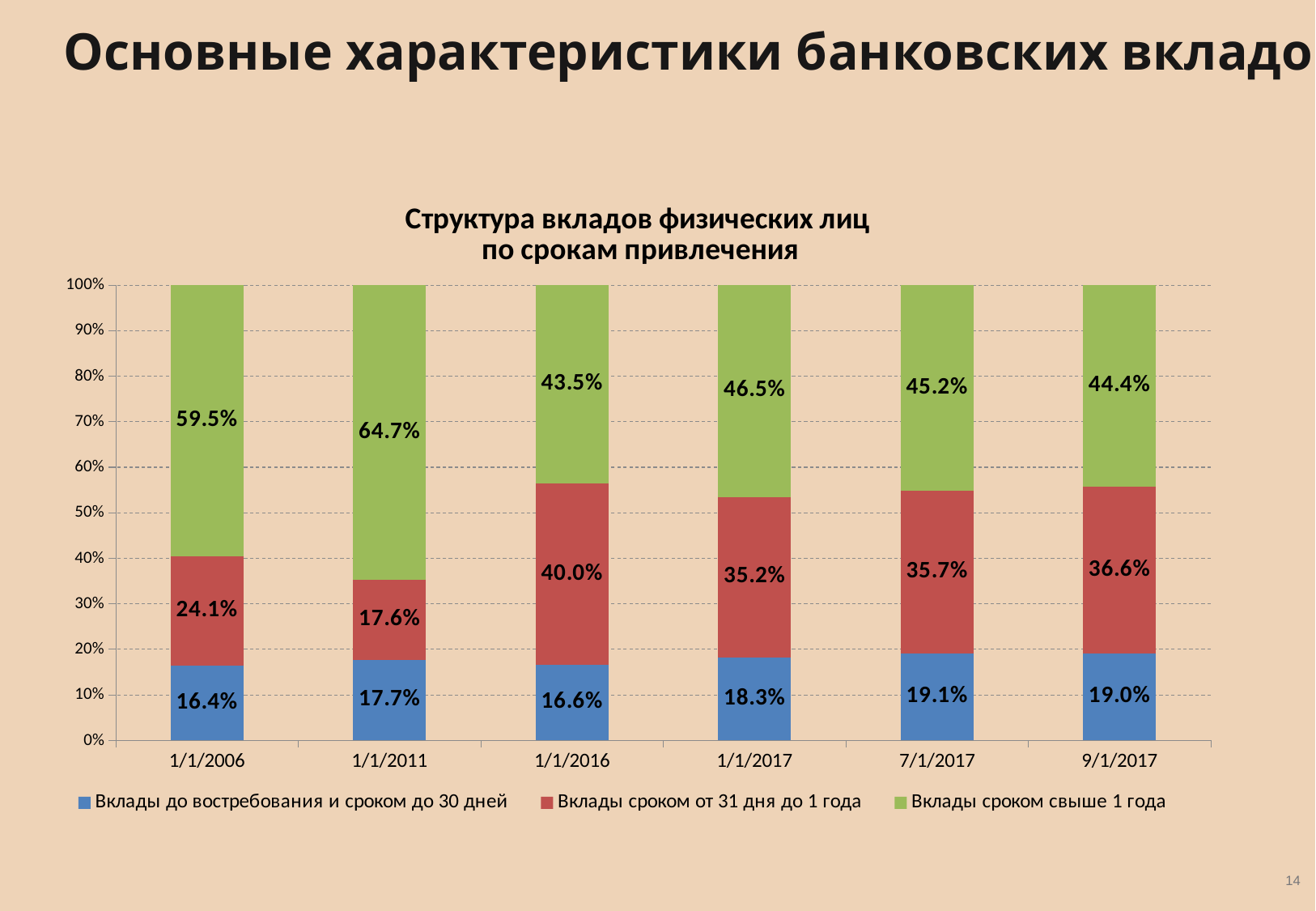
Does the share of deposits with a term over 1 year rise or fall from 1/1/2011 to 1/1/2016? Fall Which is larger on 1/1/2017: the share of deposits from 31 days to 1 year or the share of deposits over 1 year? Вклады сроком свыше 1 года (46.5%) What is the difference between the share of deposits over 1 year on 1/1/2006 and on 9/1/2017? 15.1% What is the value for deposits with a term from 31 days to 1 year (Вклады сроком от 31 дня до 1 года) on 1/1/2016? 40.0% What share of deposits with a term over 1 year (Вклады сроком свыше 1 года) is shown for 1/1/2011? 64.7% What is the value for demand deposits and deposits up to 30 days (Вклады до востребования и сроком до 30 дней) on 7/1/2017? 19.1% What type of chart is shown on the slide? Stacked bar chart Which colour represents deposits with a term over 1 year (Вклады сроком свыше 1 года)? Green How many series does the legend list? 3 How many dates are shown on the x axis of the chart? 6 On which date is the share of deposits with a term over 1 year the highest? 1/1/2011 On which date is the share of deposits with a term from 31 days to 1 year the lowest? 1/1/2011